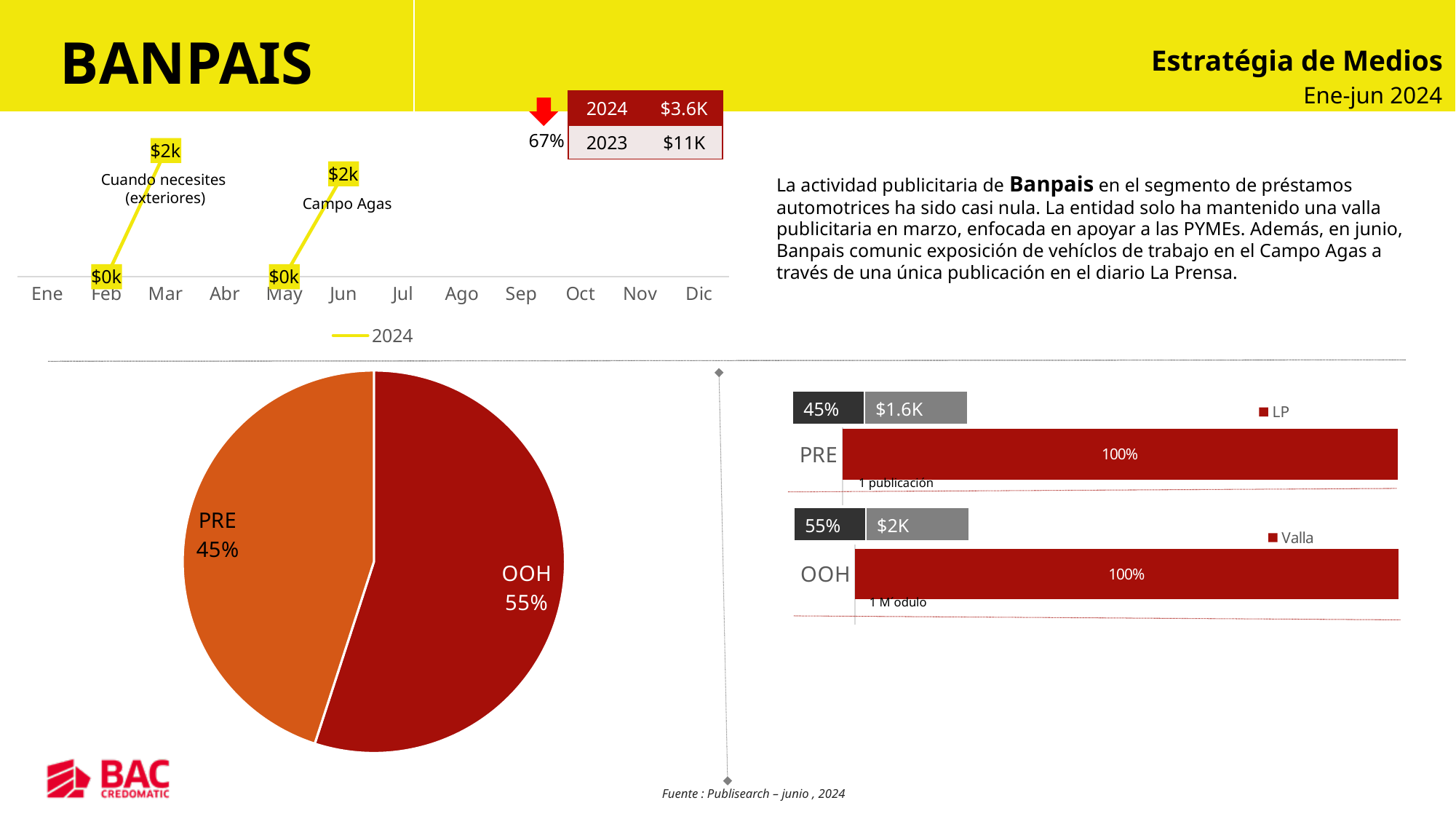
In the bar chart labelled OOH on the right, what is the value shown for Valla? 100% In the line chart at the top left, does the value rise or fall from Feb to Mar? rise In the pie chart at the bottom left, what share does OOH have? 55% In the line chart at the top left, what is the value for Feb? $0k In the pie chart at the bottom left, what share does PRE have? 45% In the line chart at the top left, what is the value for Mar? $2k In the line chart at the top left, how many month categories are shown on the x axis? 12 In the pie chart at the bottom left, which slice is larger, PRE or OOH? OOH In the line chart at the top left, what series name does the legend show? 2024 In the line chart at the top left, what is the value for Jun? $2k In the line chart at the top left, what is the value for May? $0k In the line chart at the top left, how many series does the legend list? 1